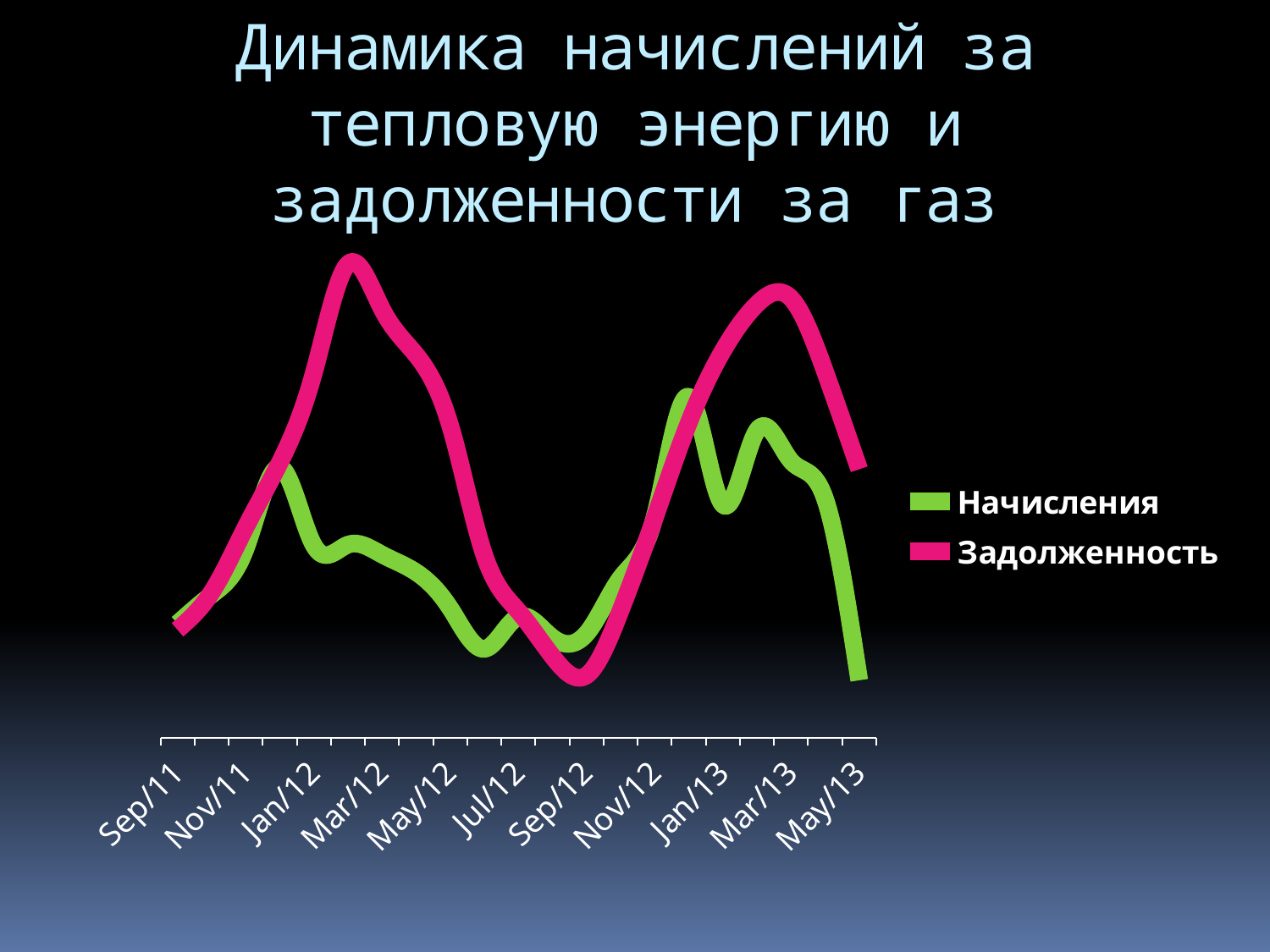
At May/13, which series has the higher value, Начисления or Задолженность? Задолженность At Sep/12, which series has the higher value, Начисления or Задолженность? Начисления What is the first month label on the x axis? Sep/11 At Mar/12, which series has the higher value, Начисления or Задолженность? Задолженность What kind of chart is shown on the slide? line chart What are the two series named in the legend? Начисления and Задолженность Does the Начисления line rise or fall from Mar/13 to May/13? fall Does the Задолженность line rise or fall from Sep/11 to Jan/12? rise What is the last month label on the x axis? May/13 How many month labels are shown on the x axis? 11 Which series is drawn in pink? Задолженность How many series does the legend list? 2